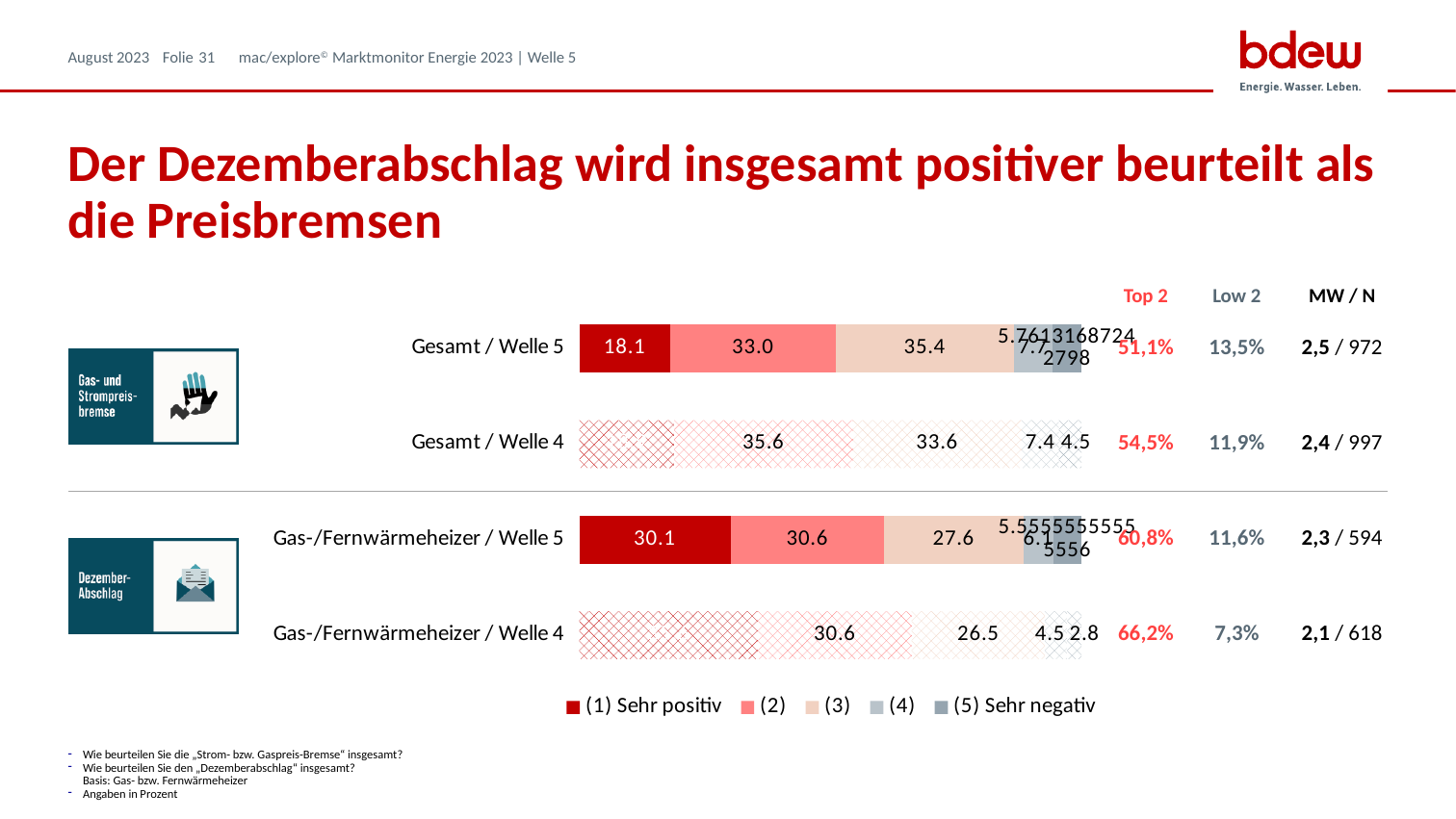
What kind of chart is shown on the slide? Stacked bar chart What is the value of the (4) segment for Gesamt / Welle 4? 7.4 What is the Top 2 value shown for Gas-/Fernwärmeheizer / Welle 4? 66,2% How many bars (rows) are plotted in the chart? 4 What is the value of the (5) Sehr negativ segment for Gas-/Fernwärmeheizer / Welle 4? 2.8 How many series does the chart legend list? 5 What is the difference between the (3) segment of Gesamt / Welle 5 and the (3) segment of Gas-/Fernwärmeheizer / Welle 5? 7.8 Which has the larger (1) Sehr positiv value: Gesamt / Welle 5 or Gas-/Fernwärmeheizer / Welle 5? Gas-/Fernwärmeheizer / Welle 5 Within the Gesamt / Welle 5 bar, which labeled segment has the highest value? (3) What is the value of the (3) segment for Gas-/Fernwärmeheizer / Welle 5? 27.6 What is the value of the (2) segment for Gesamt / Welle 4? 35.6 What is the value of the (1) Sehr positiv segment for Gesamt / Welle 5? 18.1